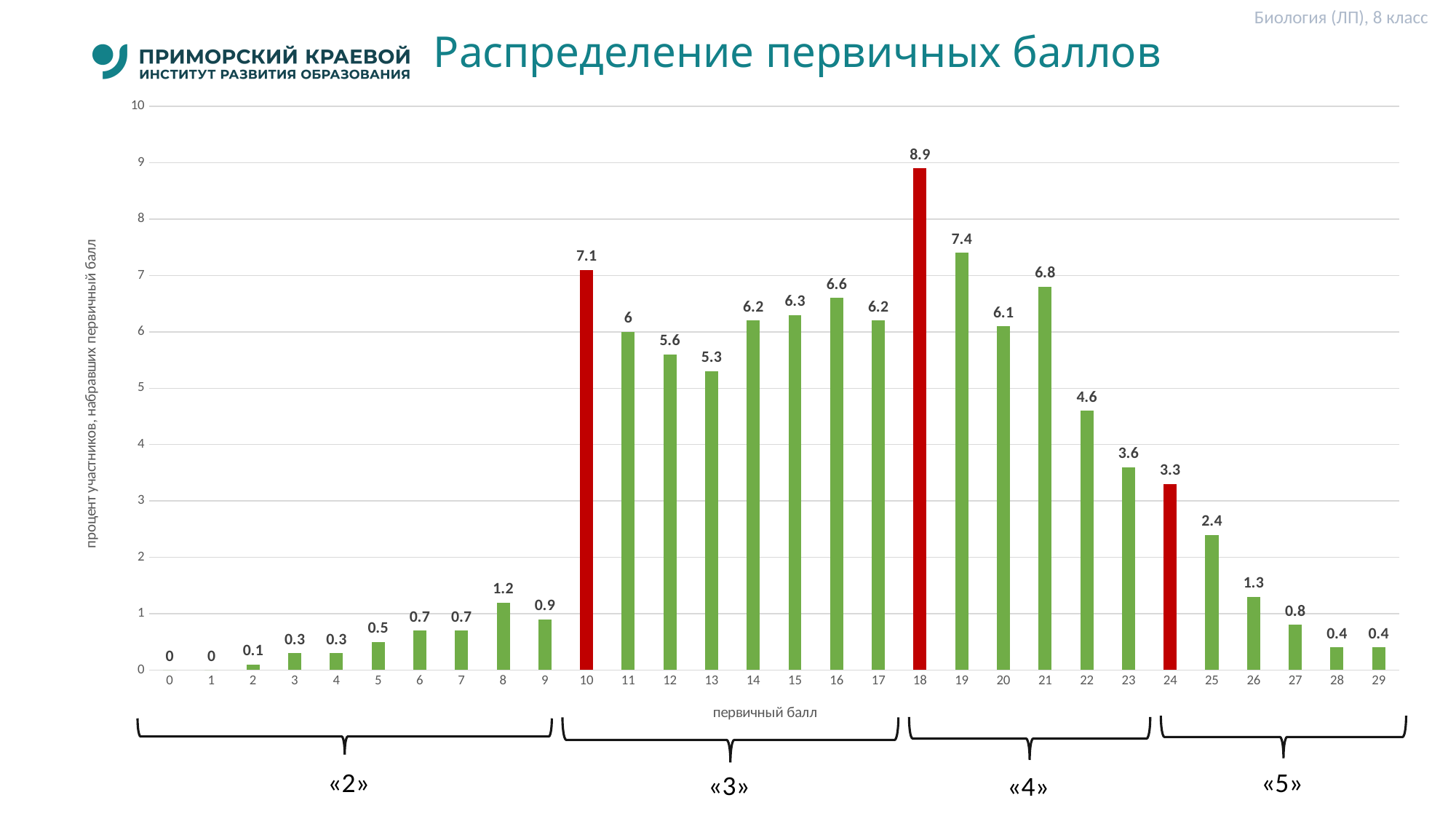
Which is larger, the value for primary score 16 or for primary score 21? 21 What is the difference between the values for primary scores 10 and 24? 3.8 How many primary score categories are shown on the x axis? 30 What is the value for primary score 10? 7.1 What is the value for primary score 18? 8.9 Do the values rise or fall from primary score 18 to primary score 29? fall Which primary score has the highest percentage of participants? 18 What colour is the bar for primary score 18? red Is the value for primary score 22 greater or less than 4? greater What is the difference between the values for primary scores 18 and 19? 1.5 What kind of chart is shown on the slide? bar chart What is the value for primary score 24? 3.3